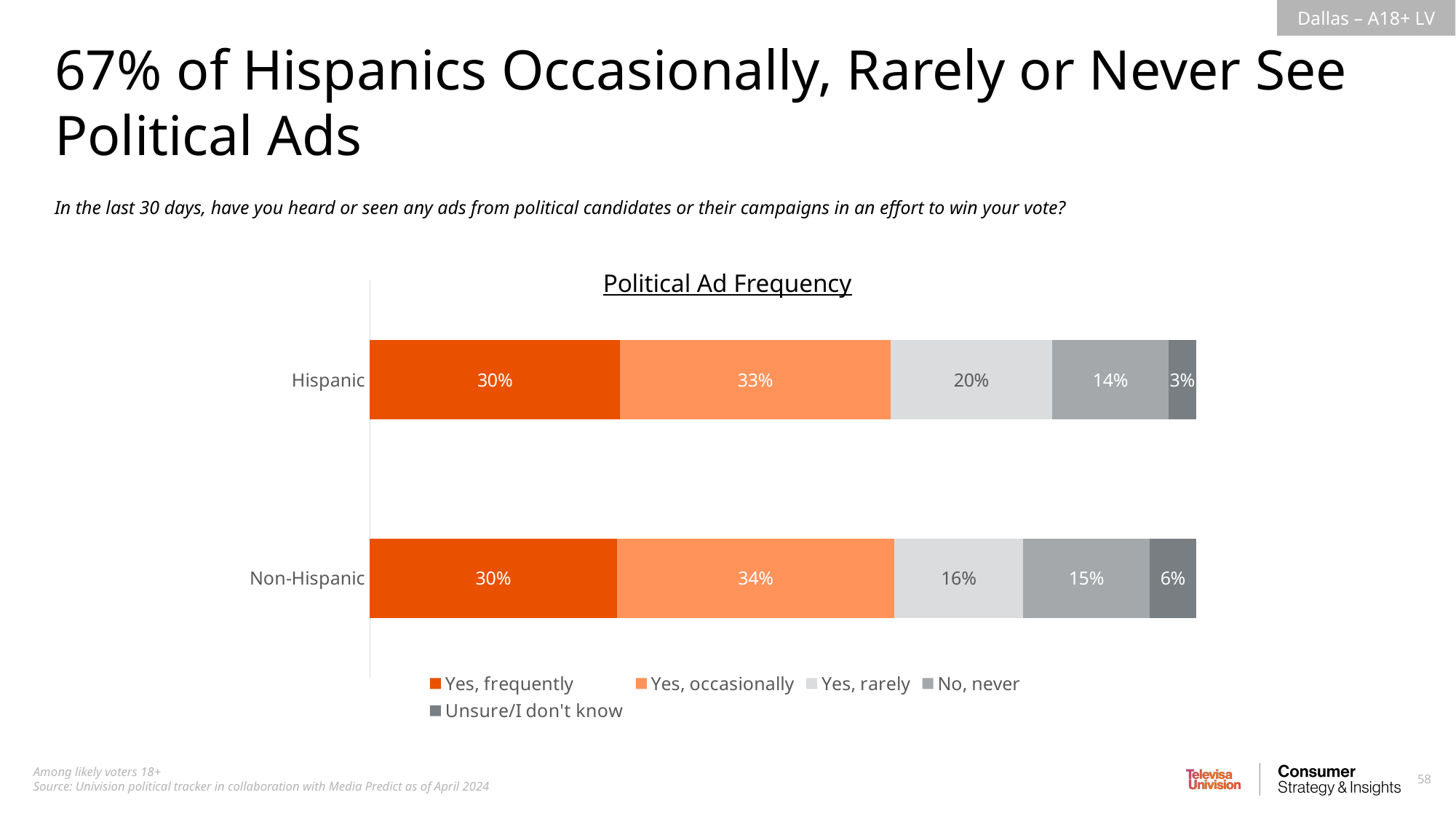
What is the value for "Yes, occasionally" in the Hispanic bar? 33% What is the value for "Yes, rarely" in the Non-Hispanic bar? 16% Which series has the lowest value in the Non-Hispanic bar? Unsure/I don't know Which group has the larger "Unsure/I don't know" value, Hispanic or Non-Hispanic? Non-Hispanic How many categories (bars) are shown in the chart? 2 What is the value for "No, never" in the Non-Hispanic bar? 15% What kind of chart is shown on the slide? Stacked bar chart What is the value for "Unsure/I don't know" in the Hispanic bar? 3% What is the title of the chart? Political Ad Frequency Which series has the highest value in the Hispanic bar? Yes, occasionally What is the difference between the "Yes, rarely" values for Hispanic and Non-Hispanic? 4 percentage points How many series does the legend list? 5